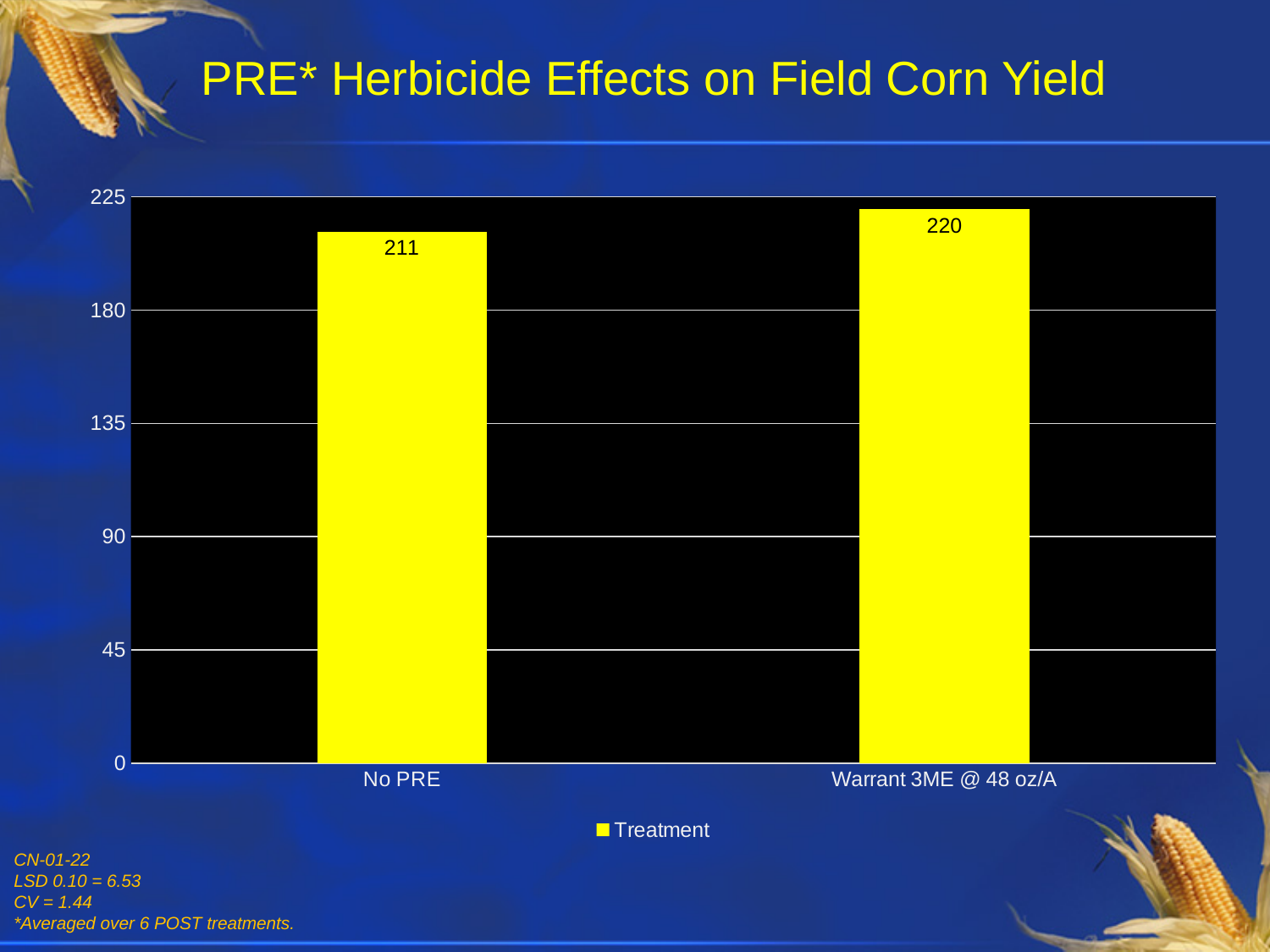
What kind of chart is shown on the slide? bar chart Is the value for No PRE greater or less than 180? greater What series name is listed in the legend? Treatment How many categories are shown on the x axis? 2 What is the difference between the values for Warrant 3ME @ 48 oz/A and No PRE? 9 What is the title of the chart? PRE* Herbicide Effects on Field Corn Yield What is the yield value for No PRE? 211 What is the yield value for Warrant 3ME @ 48 oz/A? 220 Which is larger, the value for No PRE or the value for Warrant 3ME @ 48 oz/A? Warrant 3ME @ 48 oz/A Which category has the lowest value? No PRE Which category has the highest value? Warrant 3ME @ 48 oz/A How many series does the legend list? 1